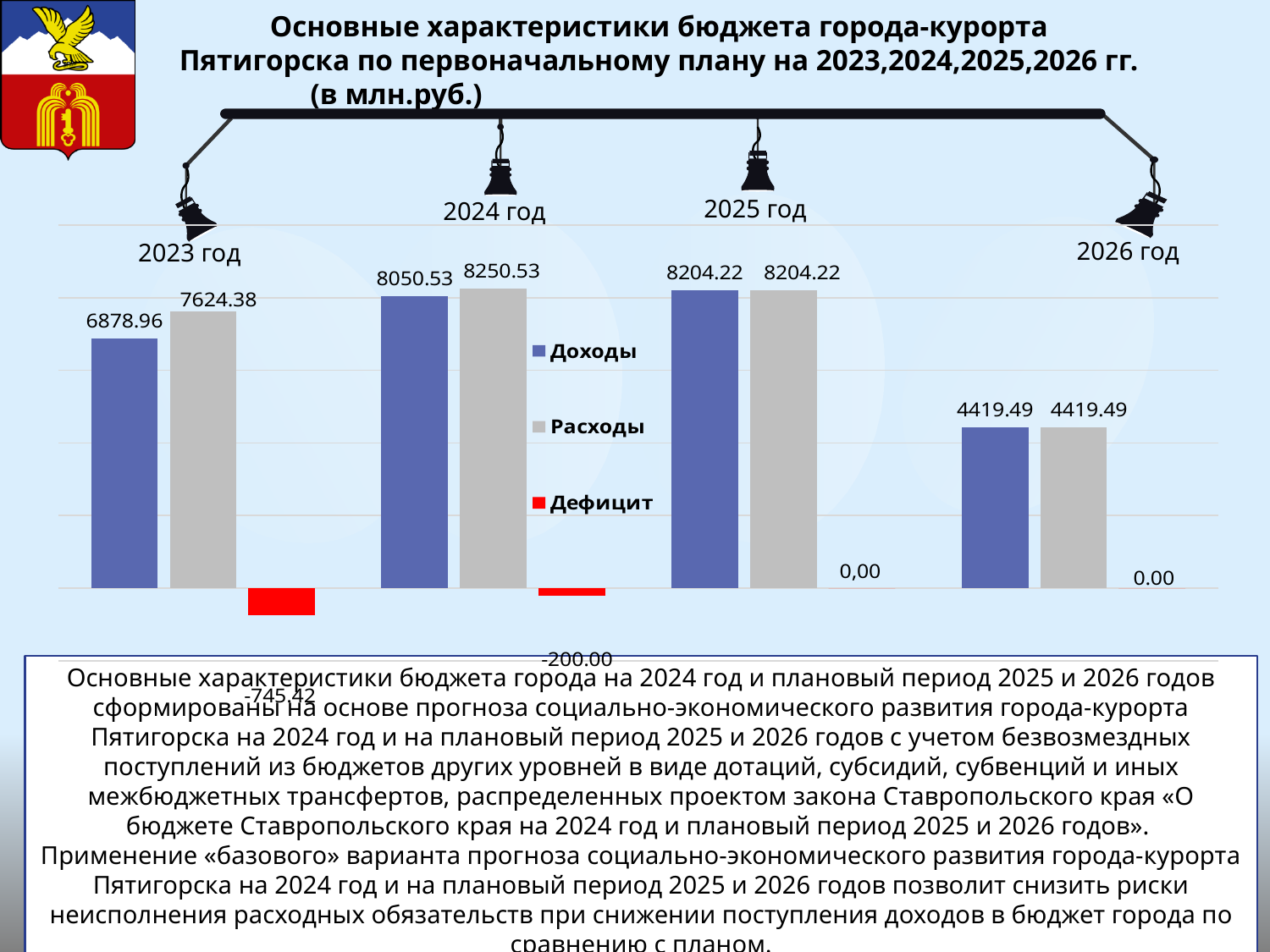
Which is larger for 2024 год, Доходы or Расходы? Расходы What is the value of Дефицит for 2024 год? -200.00 What is the value of Доходы for 2023 год? 6878.96 What kind of chart is shown on the slide? bar chart How many years are shown on the chart? 4 What is the difference between Расходы and Доходы for 2023 год? 745.42 What are the three series listed in the chart legend? Доходы, Расходы, Дефицит In which year is Расходы the lowest? 2026 год What is the value of Расходы for 2024 год? 8250.53 How many series does the chart legend list? 3 What is the value of Доходы for 2026 год? 4419.49 In which year is Доходы the highest? 2025 год